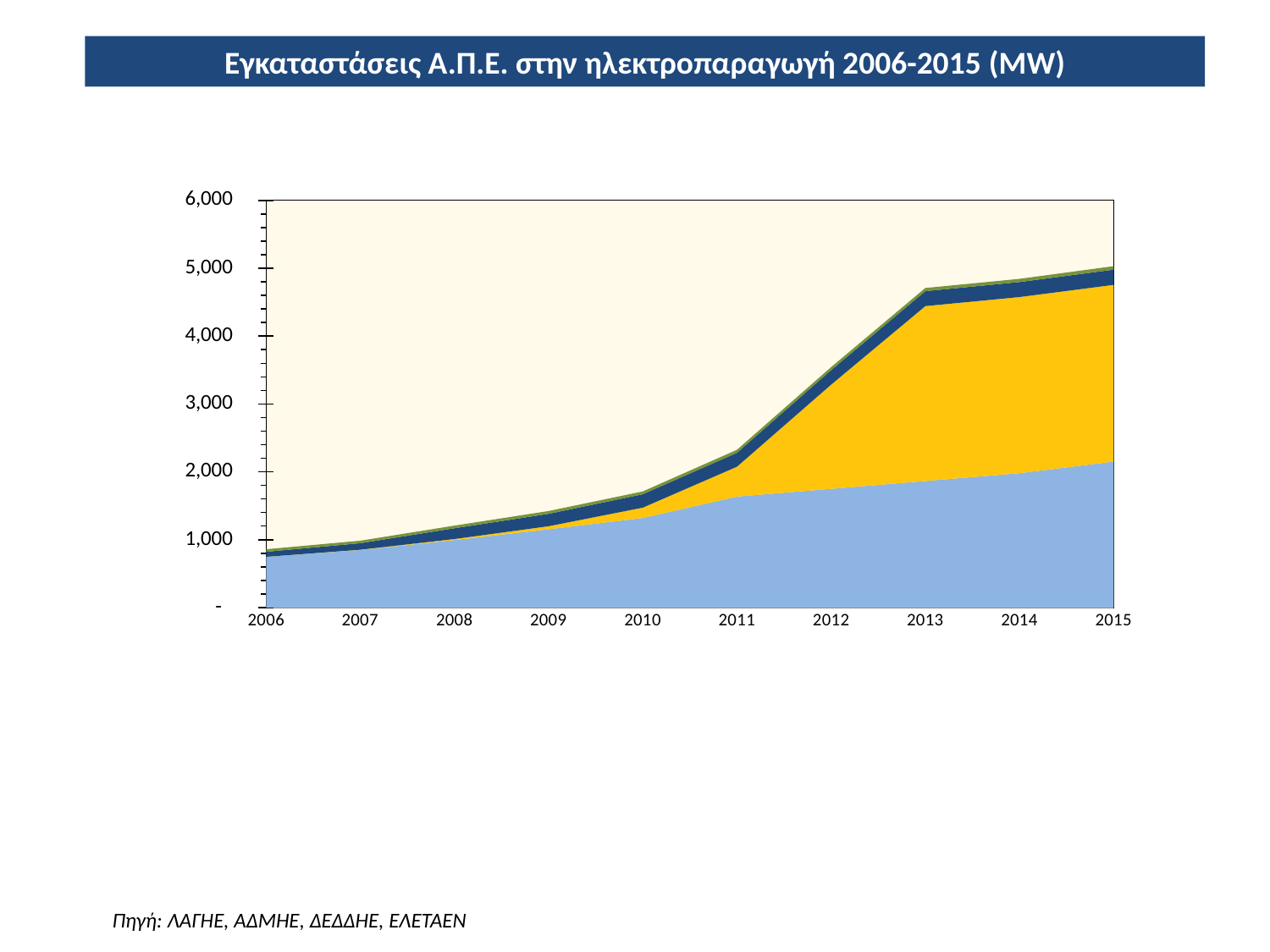
Is the total stacked value for 2013 larger than the total for 2011? Yes What kind of chart is shown on the slide? Stacked area chart Is the total stacked value for 2010 greater or less than 2,000? less What is the title of the chart? Εγκαταστάσεις Α.Π.Ε. στην ηλεκτροπαραγωγή 2006-2015 (MW) Is the total stacked value for 2012 greater or less than 3,000? greater Is the total stacked value for 2013 greater or less than 4,000? greater Do the total installed values rise or fall from 2006 to 2015? Rise How many years are plotted along the x axis? 10 In which year is the total stacked value highest? 2015 In which year is the total stacked value lowest? 2006